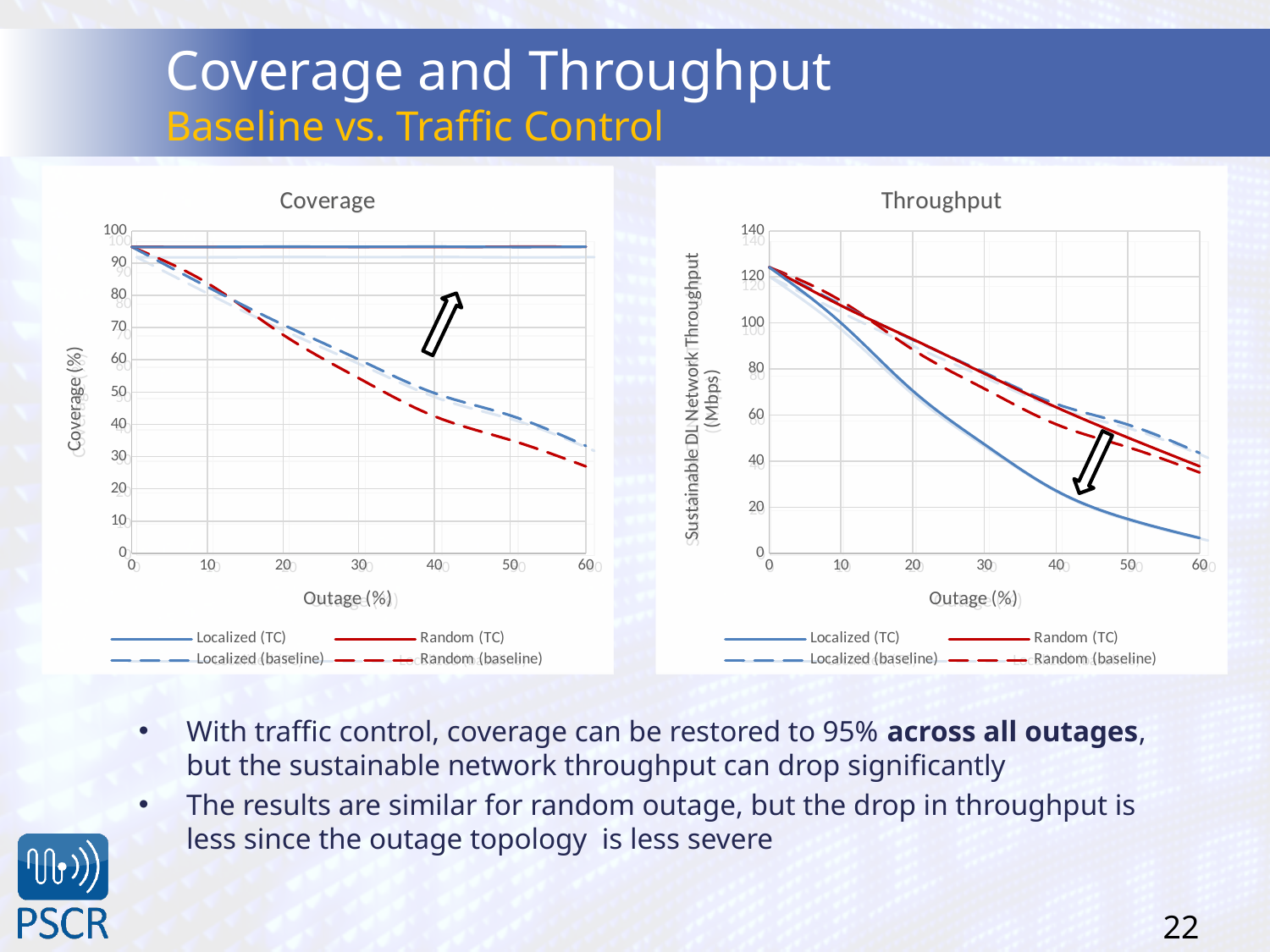
In the Coverage chart, is the value for Localized (TC) at 60% outage greater or less than 90? greater In the Coverage chart, at 60% outage, which is larger: Localized (baseline) or Random (baseline)? Localized (baseline) In the Coverage chart, is the value for Random (baseline) at 60% outage greater or less than 30? less How many series does the legend of the Throughput chart list? 4 In the Throughput chart, does the Localized (TC) series rise or fall as outage increases? fall In the Coverage chart, does the Localized (baseline) series rise or fall as outage increases? fall What is the y-axis label of the Throughput chart? Sustainable DL Network Throughput (Mbps) What is the x-axis label of the Coverage chart? Outage (%) In the Throughput chart, at 60% outage, which is larger: Localized (TC) or Random (TC)? Random (TC) What kind of chart is the Coverage chart? line chart In the Throughput chart, is the value for Localized (TC) at 60% outage greater or less than 20? less